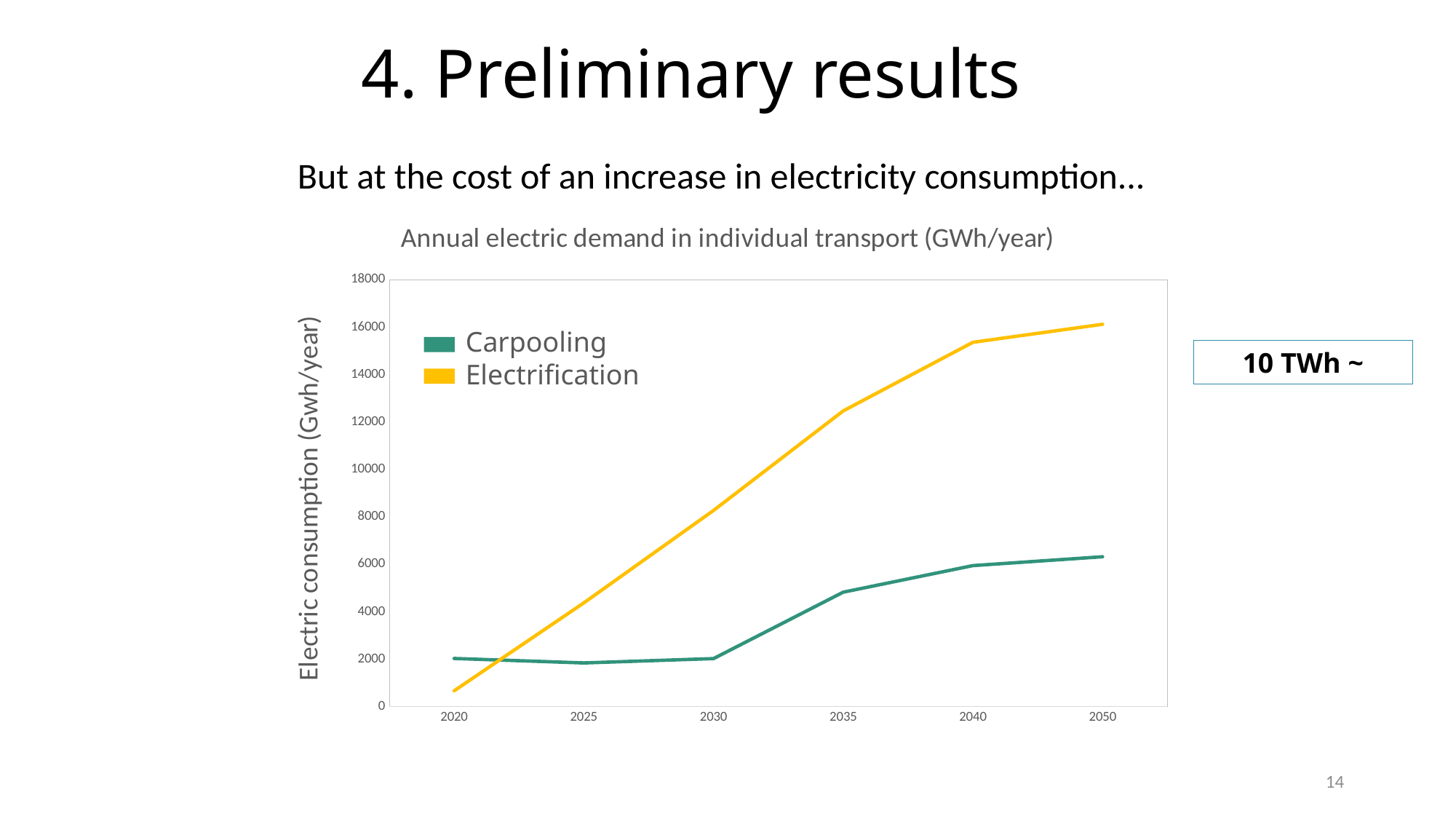
Is the Electrification value in 2020 greater or less than 2000? less Is the Carpooling value in 2050 greater or less than 8000? less How many series does the chart legend list? 2 Is the Carpooling value in 2035 greater or less than 4000? greater Which series has the higher value in 2050, Carpooling or Electrification? Electrification How many years are marked along the x axis of the chart? 6 What is the title of the chart? Annual electric demand in individual transport (GWh/year) Does the Electrification line rise or fall from 2020 to 2050? rise Which series has the higher value in 2020, Carpooling or Electrification? Carpooling What kind of chart is shown on the slide? line chart